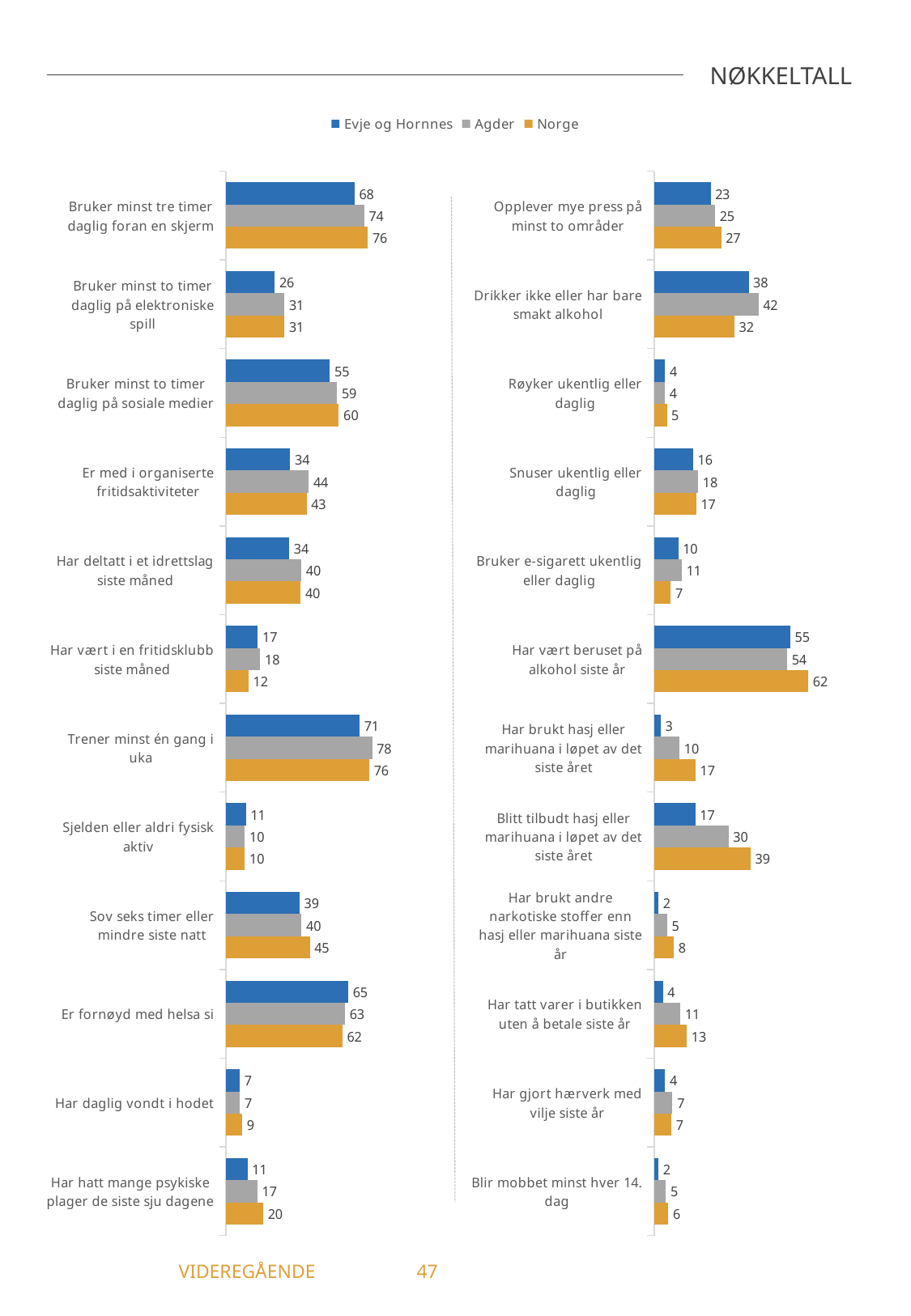
In the right chart, what is the value for Norge for "Har vært beruset på alkohol siste år"? 62 How many categories are shown in the left chart? 12 In the left chart, which category has the highest value for Norge? Bruker minst tre timer daglig foran en skjerm / Trener minst én gang i uka (both 76) Which colour represents Norge in the legend? Orange In the right chart, what is the value for Agder for "Drikker ikke eller har bare smakt alkohol"? 42 In the left chart, what is the value for Agder for "Er med i organiserte fritidsaktiviteter"? 44 In the left chart, what is the value for Evje og Hornnes for "Bruker minst tre timer daglig foran en skjerm"? 68 What kind of chart is the right chart? Bar chart In the right chart, which category has the lowest value for Evje og Hornnes? Har brukt andre narkotiske stoffer enn hasj eller marihuana siste år / Blir mobbet minst hver 14. dag (both 2) How many series does the legend list? 3 In the right chart, what is the difference between Norge and Evje og Hornnes for "Blitt tilbudt hasj eller marihuana i løpet av det siste året"? 22 In the left chart, which is larger for "Trener minst én gang i uka": Evje og Hornnes or Agder? Agder